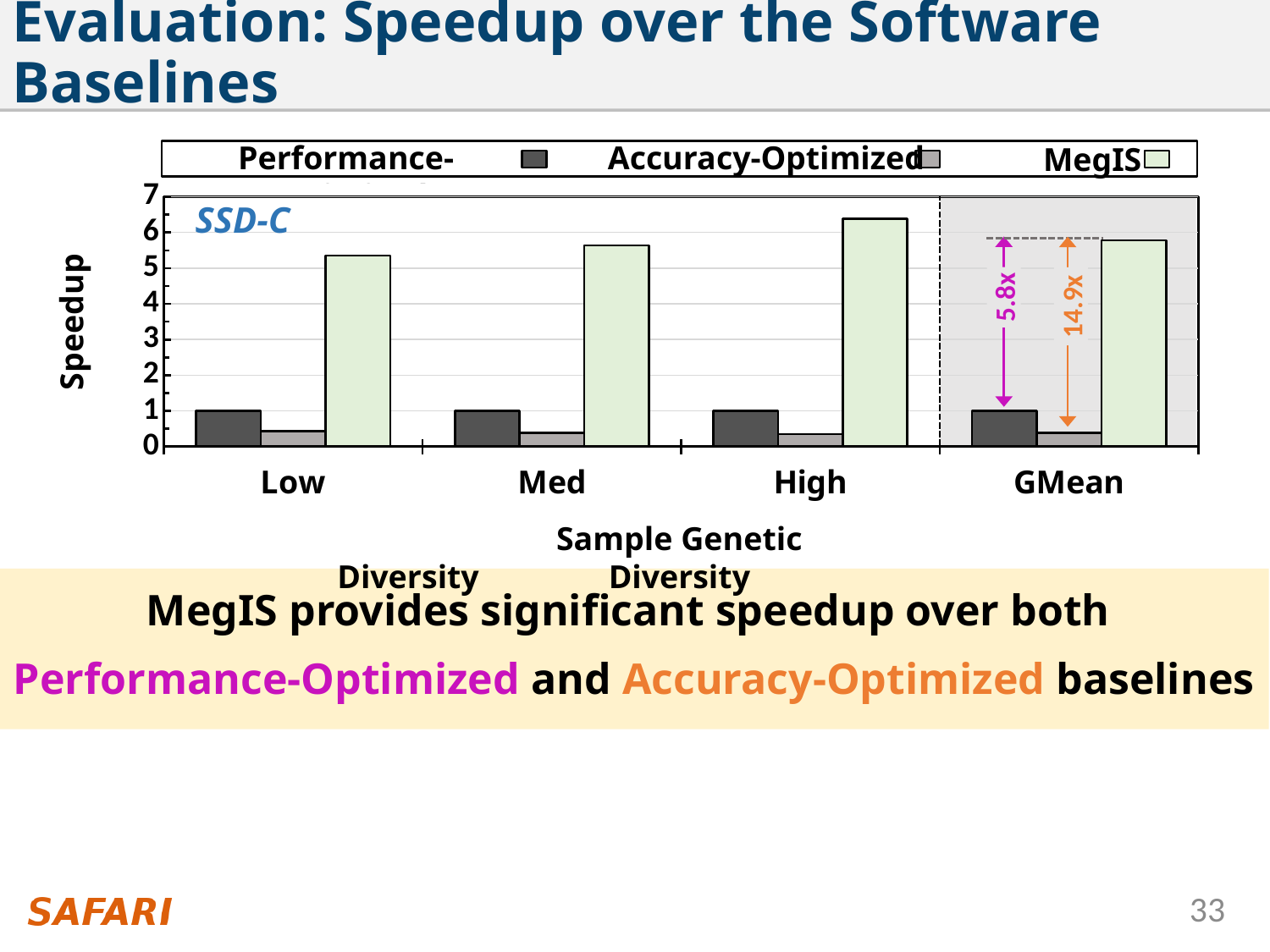
Is the MegIS value for High greater or less than 6? greater At Med, which is larger: the MegIS bar or the Performance-Optimized bar? MegIS How many categories are shown on the x axis of the chart? 4 How many series does the chart's legend list? 3 Is the Accuracy-Optimized value for Med greater or less than 1? less Do the MegIS values rise or fall from Low to High? rise Is the MegIS value for Low greater or less than 6? less What is the label on the y axis of the chart? Speedup According to the annotation at GMean, what is the speedup of MegIS over the Accuracy-Optimized baseline? 14.9x What kind of chart is shown on the slide? bar chart According to the annotation at GMean, what is the speedup of MegIS over the Performance-Optimized baseline? 5.8x For which category is the MegIS bar the highest? High